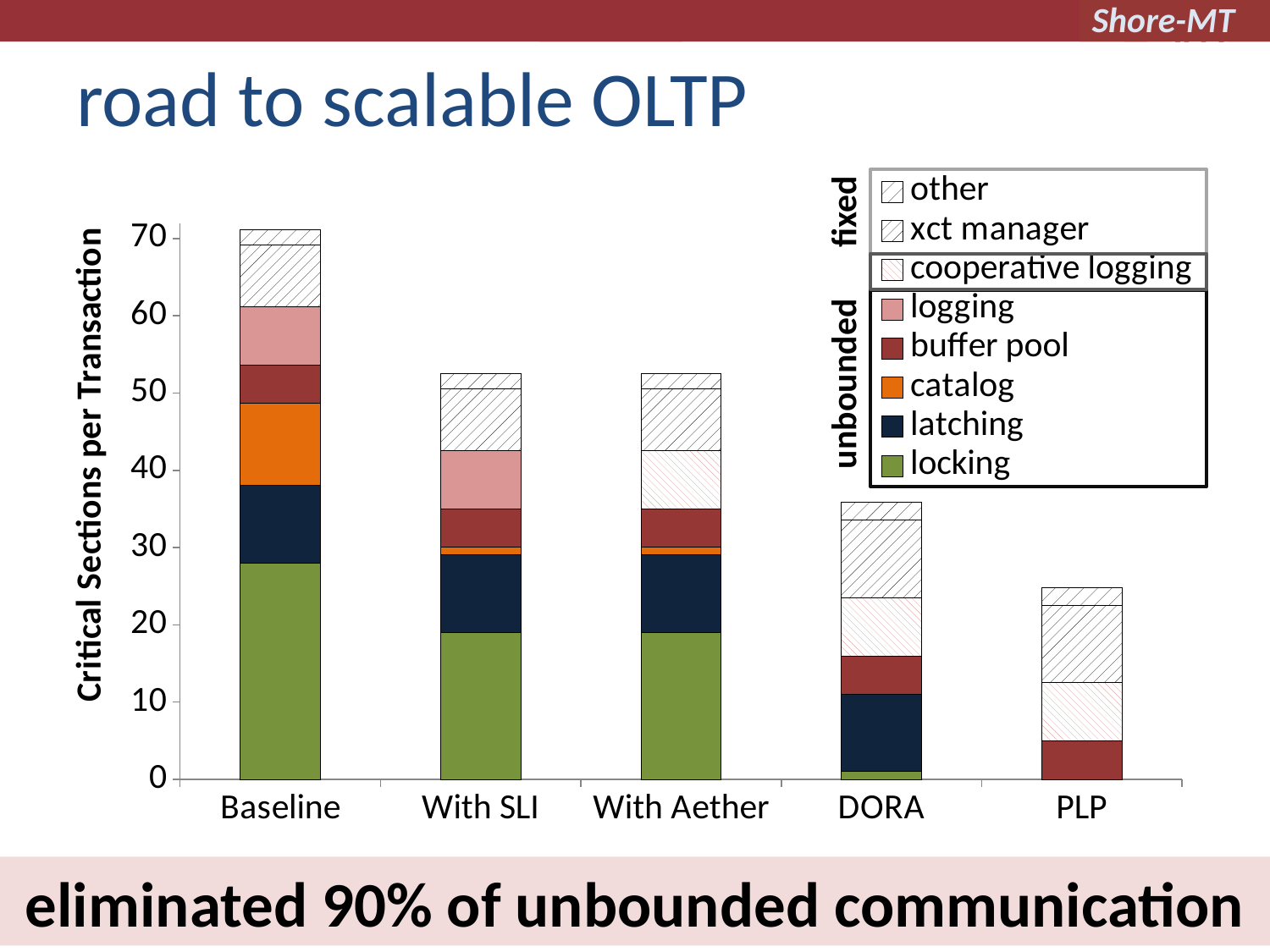
What kind of chart is shown on the slide? stacked bar chart Which category has the tallest stacked bar? Baseline How many categories are shown on the x axis? 5 What is the title of the y axis? Critical Sections per Transaction Do the bar totals generally rise or fall from Baseline to PLP? fall Is the total for PLP greater or less than 30? less Which has the larger total, DORA or PLP? DORA How many series does the legend list? 8 Is the total for With SLI greater or less than 50? greater Is the total for Baseline greater or less than 60? greater Which category has the shortest stacked bar? PLP